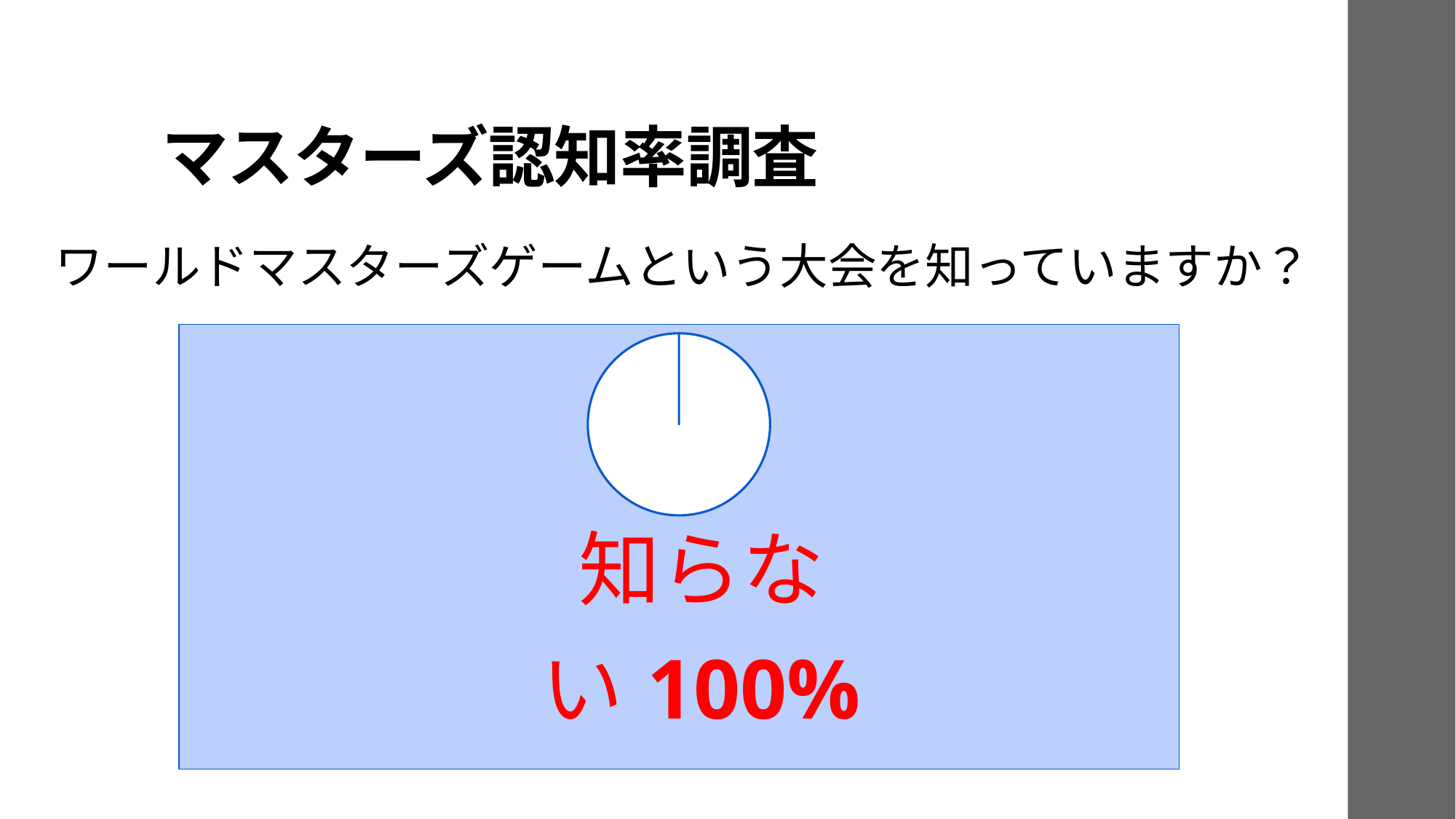
What kind of chart is shown on the slide? pie chart What percentage is shown for 知らない in the pie chart? 100% What share of the pie does the 知らない slice take up? 100% Which category is the largest in the pie chart? 知らない What is the title of the slide containing the pie chart? マスターズ認知率調査 What colour is the single slice of the pie chart? white Is the value for 知らない greater or less than 50%? greater How many slices does the pie chart have? 1